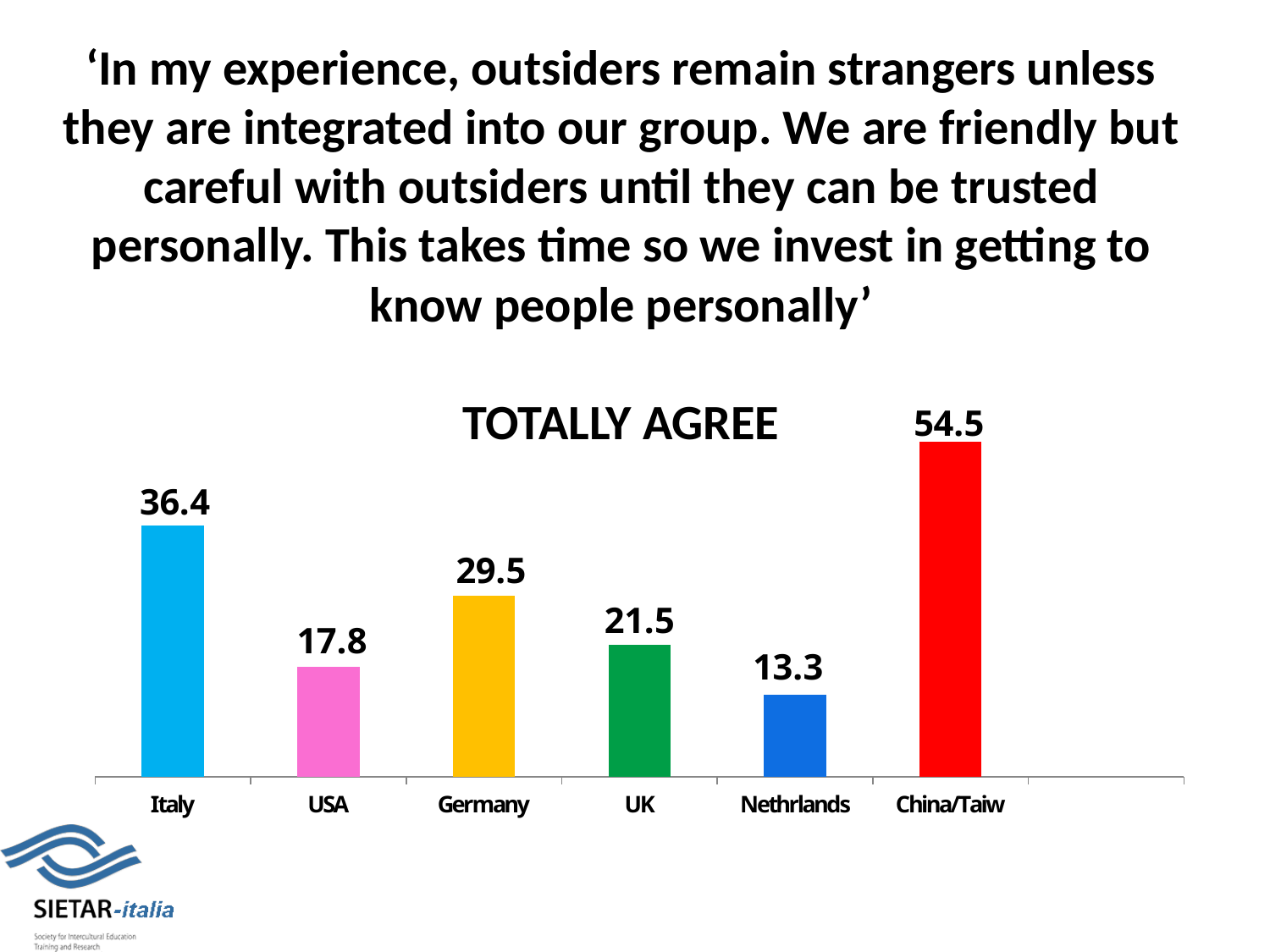
What is the title of the chart? TOTALLY AGREE What is the value for UK? 21.5 What kind of chart is shown on the slide? Bar chart What is the value for USA? 17.8 What is the value for Germany? 29.5 What is the value for Italy? 36.4 Which category has the lowest value? Nethrlands How many categories are shown on the x axis? 6 Which category has the highest value? China/Taiw What is the difference between the values for China/Taiw and Italy? 18.1 What is the value for Nethrlands? 13.3 Which is larger, the value for Germany or the value for UK? Germany